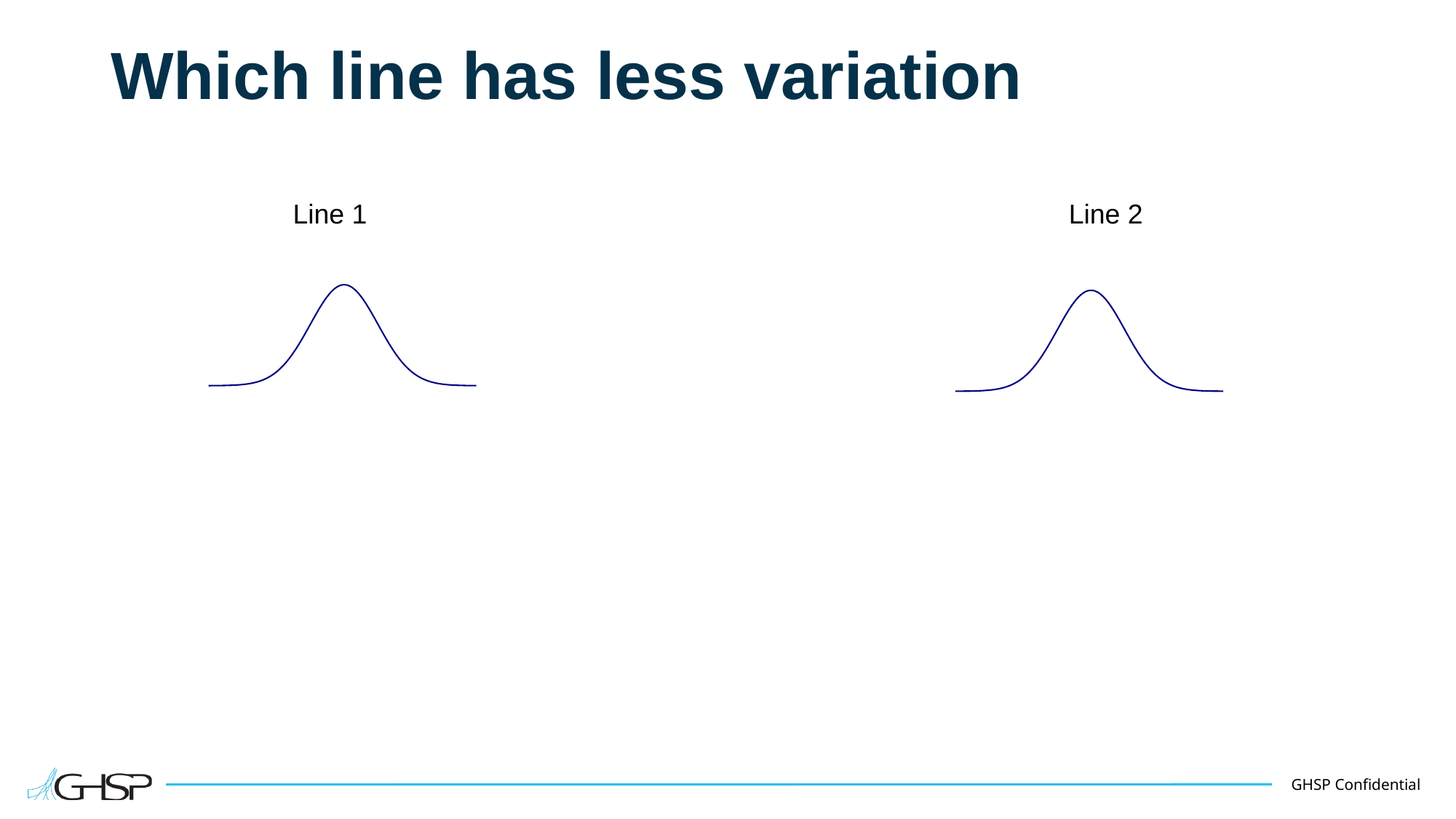
What kind of chart is the chart titled Line 2? line chart How many charts are shown on the slide? 2 What kind of chart is the chart titled Line 1? line chart What is the title of the chart on the left of the slide? Line 1 In the chart titled Line 2, does the curve rise or fall from its peak to its right end? fall In the chart titled Line 1, does the curve rise or fall from its left end to its peak? rise What is the title of the chart on the right of the slide? Line 2